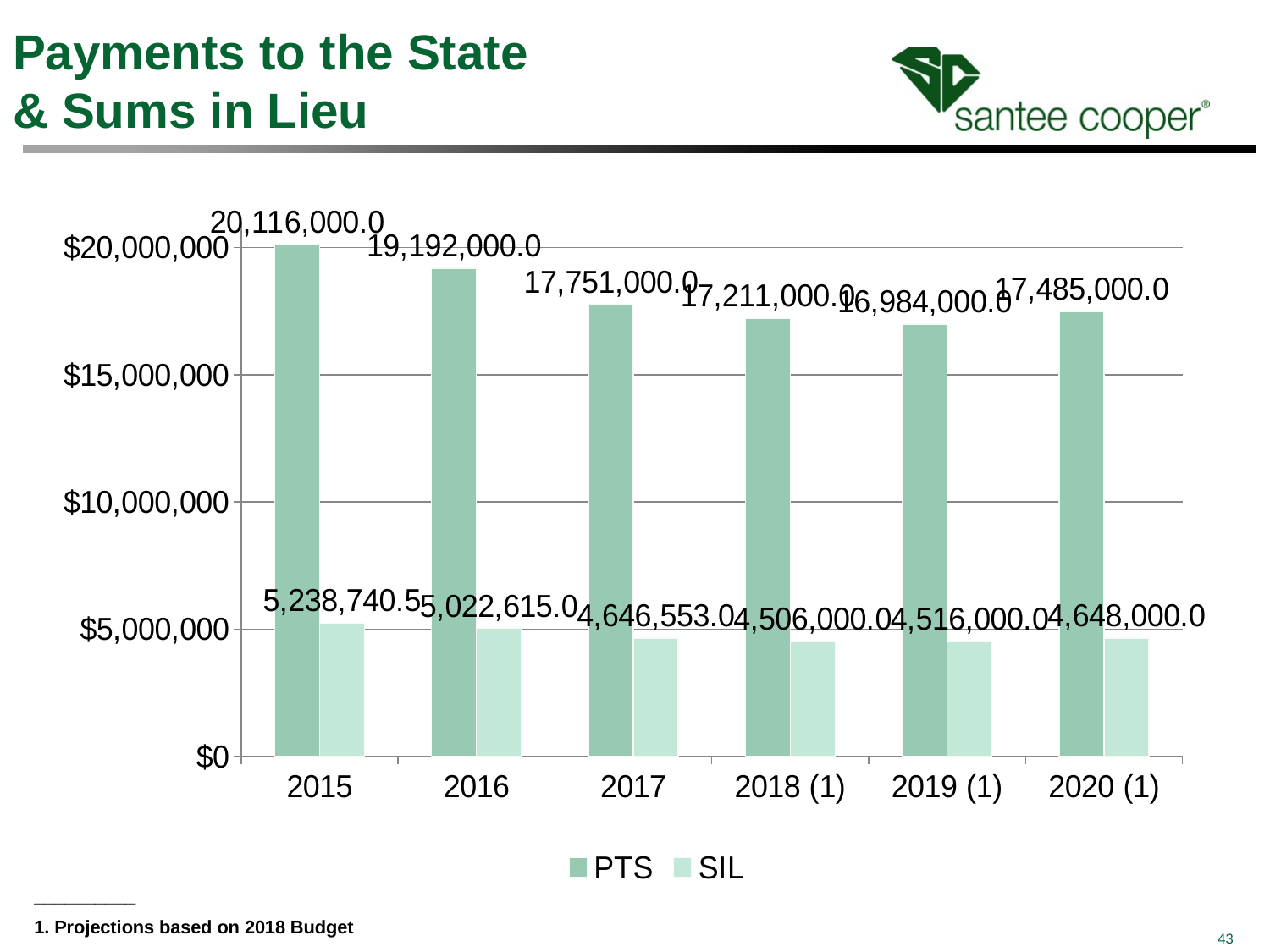
Which year has the lowest PTS value? 2019 (1) Which year has the highest PTS value? 2015 What is the SIL value for 2017? 4,646,553.0 What is the difference between the PTS values for 2015 and 2016? 924,000.0 How many series does the legend list? 2 What is the PTS value for 2015? 20,116,000.0 What is the SIL value for 2018 (1)? 4,506,000.0 Which is larger, the SIL value for 2016 or the SIL value for 2020 (1)? 2016 How many years are shown on the x axis? 6 Is the PTS value for 2017 greater or less than $15,000,000? greater What kind of chart is shown on the slide? bar chart What is the PTS value for 2020 (1)? 17,485,000.0